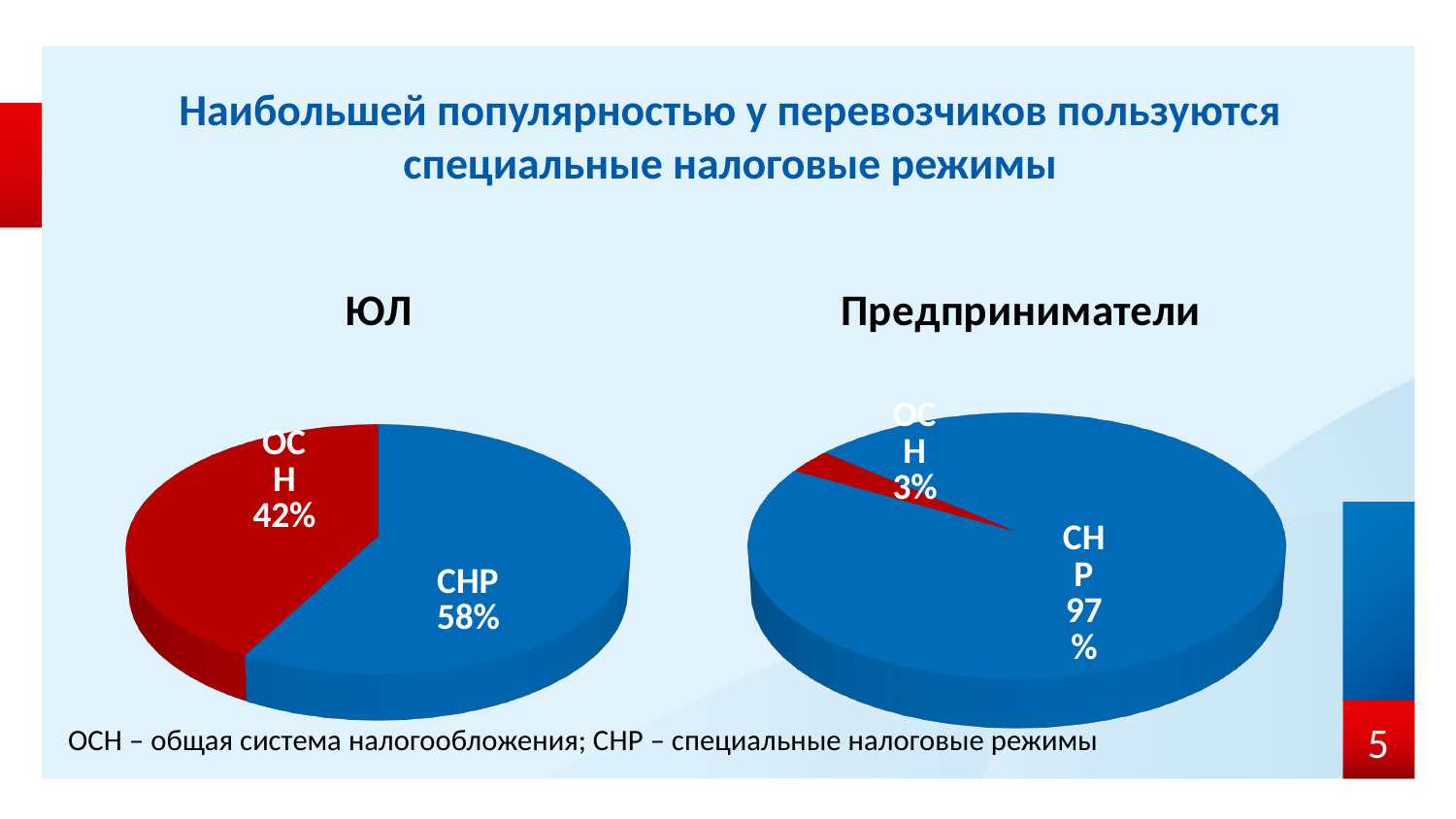
In the "Предприниматели" chart, what share does СНР have? 97% In the "Предприниматели" chart, what is the difference in percentage points between СНР and ОСН? 94 In the "ЮЛ" chart, what share does СНР have? 58% In the "ЮЛ" chart, what share does ОСН have? 42% In the "ЮЛ" chart, which slice is the largest? СНР In the "Предприниматели" chart, which slice is the smallest? ОСН In the "ЮЛ" chart, what is the difference in percentage points between СНР and ОСН? 16 Which is larger: the ОСН share in the "ЮЛ" chart or the ОСН share in the "Предприниматели" chart? ЮЛ In the "ЮЛ" chart, what colour is the ОСН slice? Red How many slices does the "ЮЛ" chart have? 2 What type of chart is the "Предприниматели" chart? Pie chart In the "Предприниматели" chart, what share does ОСН have? 3%